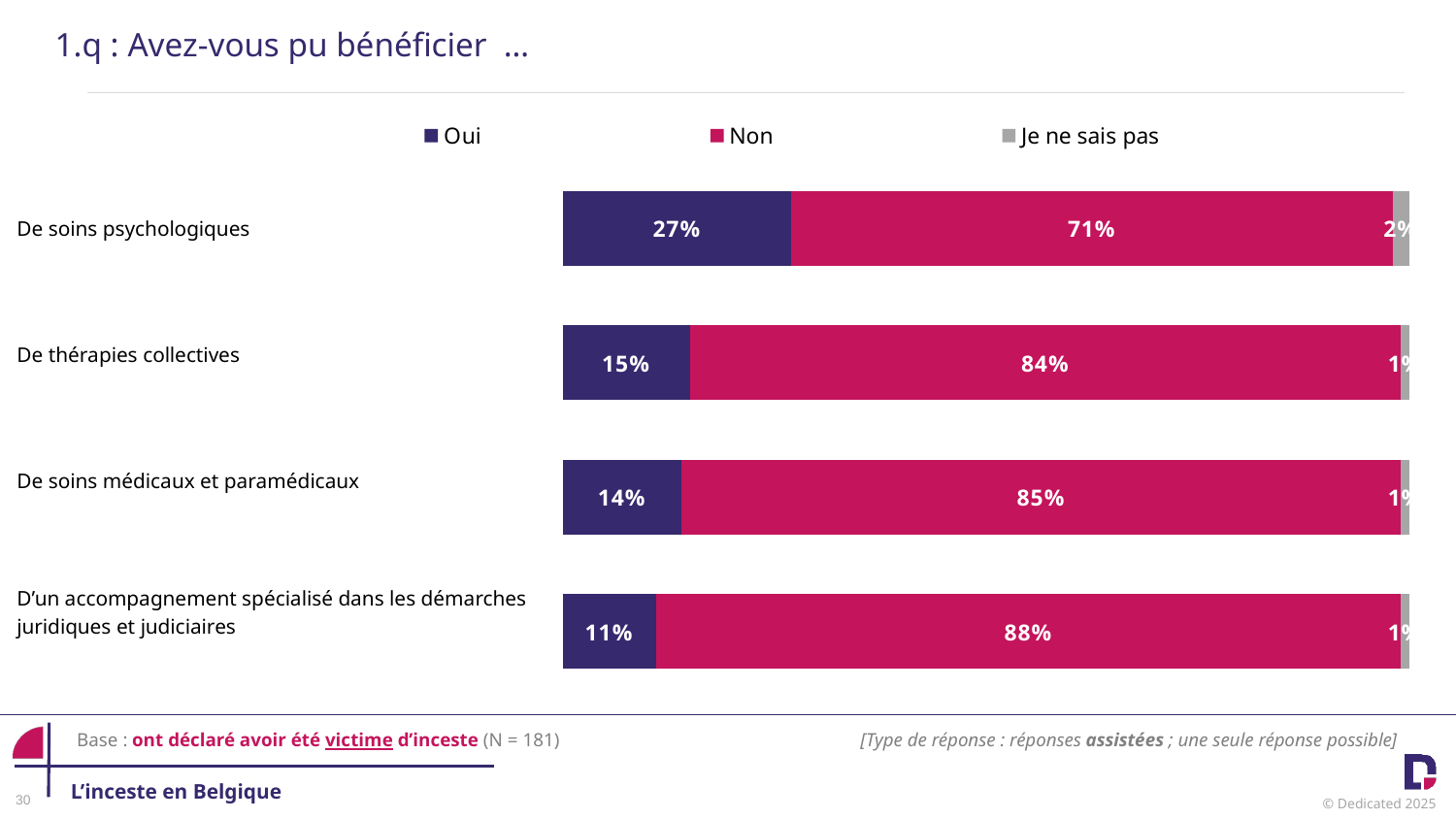
What kind of chart is shown on the slide? Stacked bar chart How many series does the legend list? 3 Which category has the highest "Oui" percentage? De soins psychologiques What percentage answered "Oui" for "De soins psychologiques"? 27% What percentage answered "Non" for "De soins médicaux et paramédicaux"? 85% Which is larger: the "Oui" percentage for "De thérapies collectives" or for "De soins médicaux et paramédicaux"? De thérapies collectives Which category has the lowest "Oui" percentage? D'un accompagnement spécialisé dans les démarches juridiques et judiciaires What percentage answered "Oui" for "D'un accompagnement spécialisé dans les démarches juridiques et judiciaires"? 11% Which category has the highest "Non" percentage? D'un accompagnement spécialisé dans les démarches juridiques et judiciaires How many categories are shown in the chart? 4 What is the difference between the "Non" percentages for "De soins psychologiques" and "De thérapies collectives"? 13 percentage points What percentage answered "Non" for "De thérapies collectives"? 84%